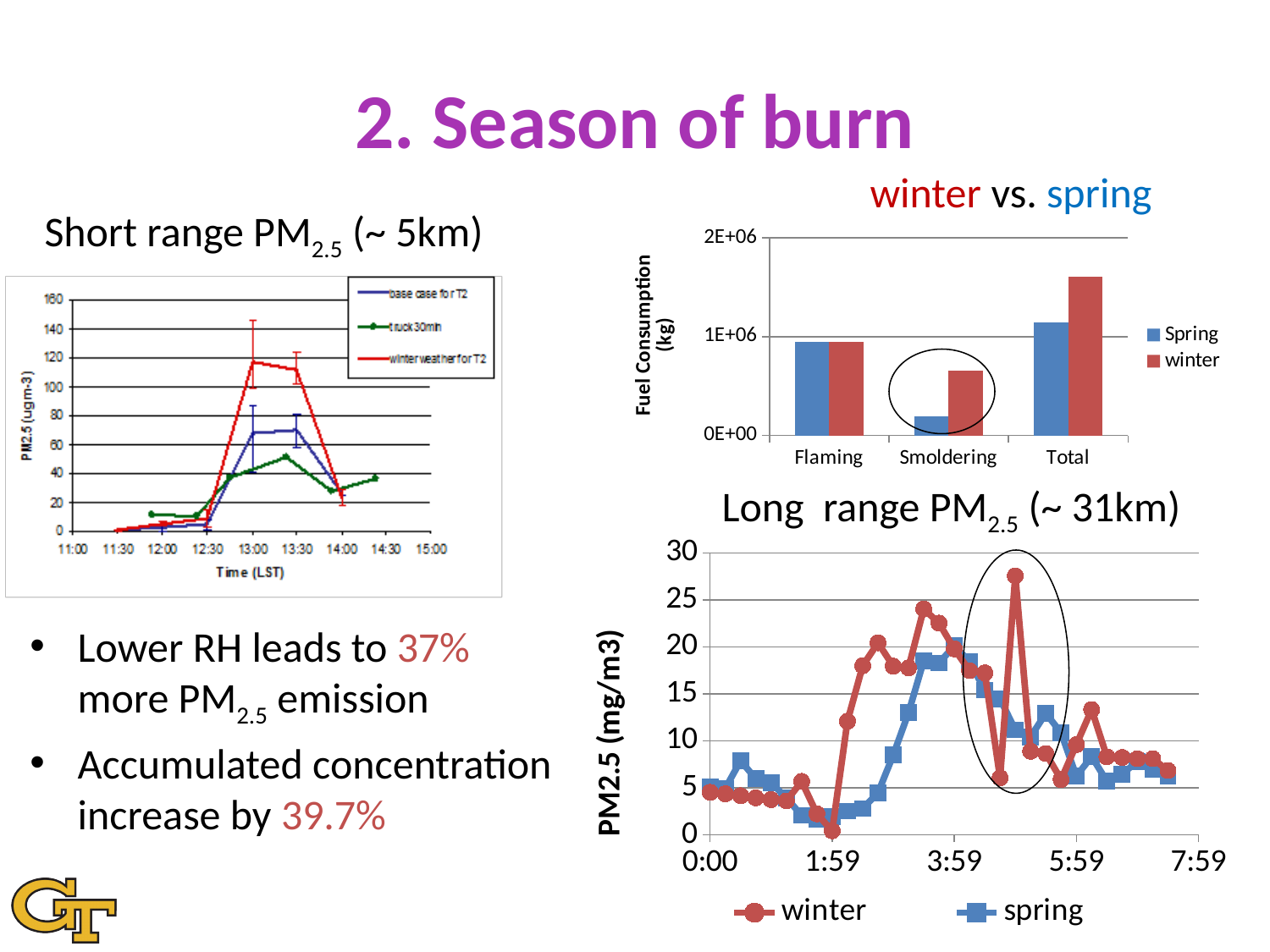
In the fuel consumption bar chart, which category has the lowest Spring value? Smoldering How many series does the legend of the Short range PM2.5 (~ 5km) chart list? 3 How many series does the legend of the fuel consumption bar chart list? 2 What kind of chart is the Long range PM2.5 (~ 31km) chart? line chart How many categories are shown on the x axis of the fuel consumption bar chart? 3 How many series does the legend of the Long range PM2.5 (~ 31km) chart list? 2 In the fuel consumption bar chart, is the winter value for Total greater or less than 1E+06? greater In the Long range PM2.5 (~ 31km) chart, is the highest winter value greater or less than 25? greater In the fuel consumption bar chart, is the Spring value for Smoldering greater or less than 1E+06? less In the fuel consumption bar chart, which series has the larger value for Smoldering, Spring or winter? winter What is the y-axis label of the Long range PM2.5 (~ 31km) chart? PM2.5 (mg/m3) What kind of chart is the fuel consumption chart at the top right of the slide? bar chart